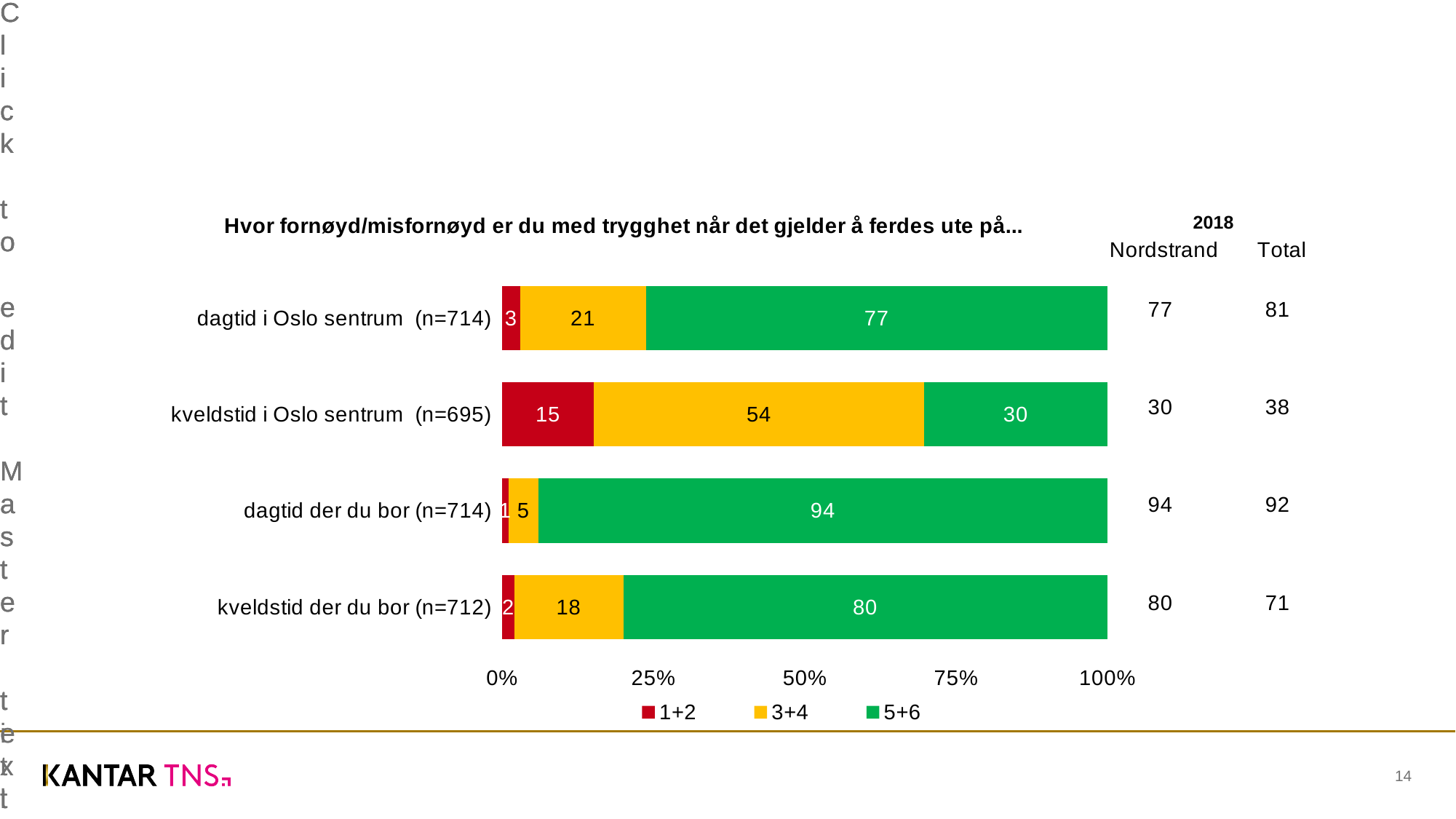
What is the value of the 1+2 segment for "kveldstid i Oslo sentrum (n=695)"? 15 Which category has the lowest 5+6 value? kveldstid i Oslo sentrum (n=695) How many categories are shown in the chart? 4 How many series does the legend list? 3 What is the difference between the 5+6 values for "dagtid der du bor (n=714)" and "kveldstid der du bor (n=712)"? 14 Which category has the highest 5+6 value? dagtid der du bor (n=714) What is the value of the 3+4 segment for "kveldstid i Oslo sentrum (n=695)"? 54 What is the value of the 5+6 segment for "dagtid i Oslo sentrum (n=714)"? 77 What colour represents the 5+6 series in the legend? Green What kind of chart is shown on the slide? Stacked bar chart Which is larger: the 3+4 value for "dagtid i Oslo sentrum (n=714)" or for "kveldstid der du bor (n=712)"? dagtid i Oslo sentrum (n=714) What is the total of the three segments for "kveldstid i Oslo sentrum (n=695)"? 99